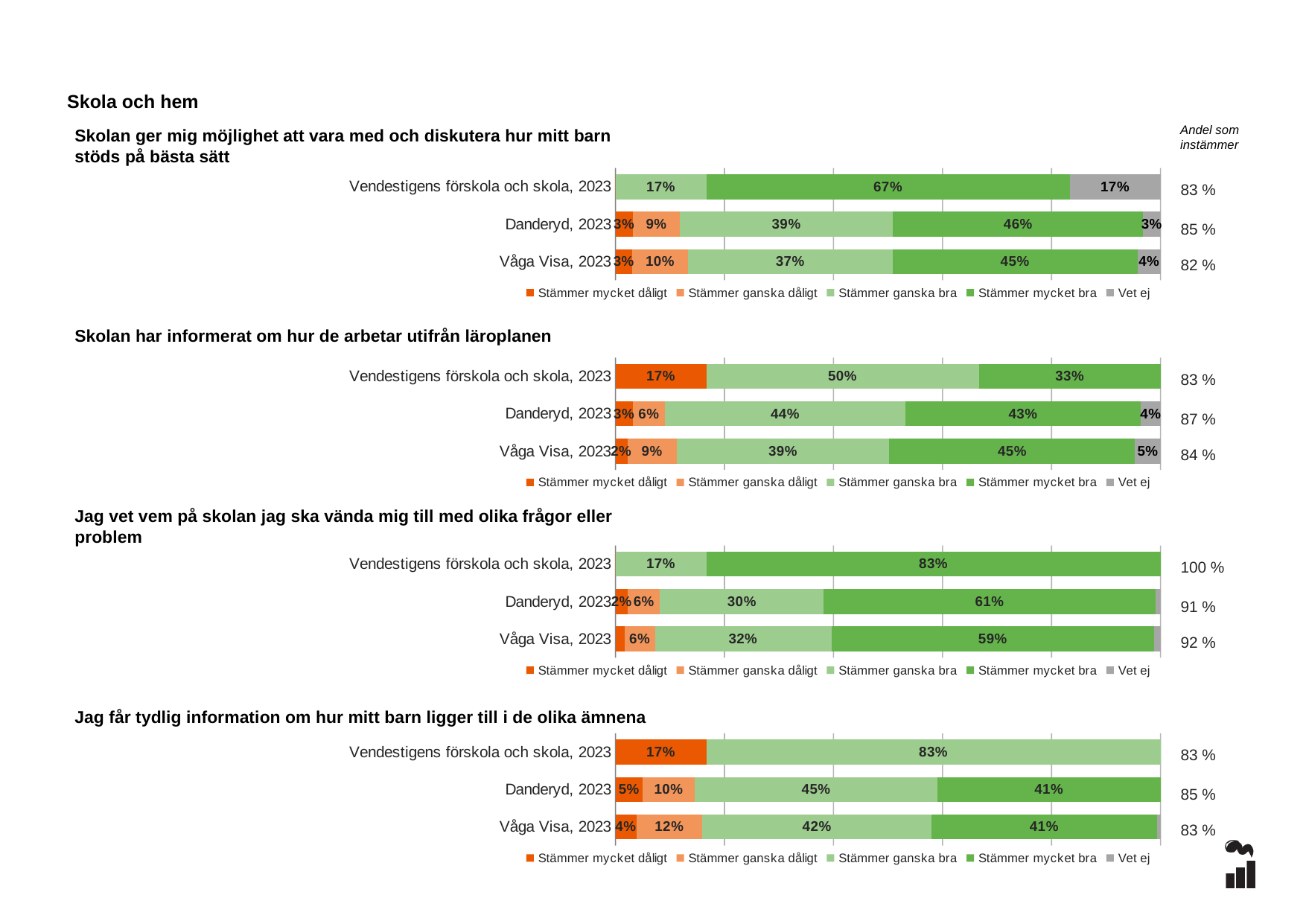
In the chart 'Jag vet vem på skolan jag ska vända mig till med olika frågor eller problem', which is larger: the 'Stämmer mycket bra' value for Danderyd, 2023 or for Våga Visa, 2023? Danderyd, 2023 How many series does the legend list for the chart 'Jag får tydlig information om hur mitt barn ligger till i de olika ämnena'? 5 In the chart 'Skolan har informerat om hur de arbetar utifrån läroplanen', what is the difference between the 'Stämmer mycket bra' values for Våga Visa, 2023 and Danderyd, 2023? 2% In the chart 'Skolan ger mig möjlighet att vara med och diskutera hur mitt barn stöds på bästa sätt', which row has the highest 'Andel som instämmer'? Danderyd, 2023 In the chart 'Skolan har informerat om hur de arbetar utifrån läroplanen', what is the 'Stämmer mycket dåligt' value for Vendestigens förskola och skola, 2023? 17% In the chart 'Skolan ger mig möjlighet att vara med och diskutera hur mitt barn stöds på bästa sätt', what is the 'Stämmer ganska bra' value for Danderyd, 2023? 39% In the chart 'Jag får tydlig information om hur mitt barn ligger till i de olika ämnena', what is the 'Stämmer ganska bra' value for Vendestigens förskola och skola, 2023? 83% In the chart 'Jag får tydlig information om hur mitt barn ligger till i de olika ämnena', what is the 'Stämmer ganska dåligt' value for Våga Visa, 2023? 12% In the chart 'Skolan har informerat om hur de arbetar utifrån läroplanen', which row has the lowest 'Andel som instämmer'? Vendestigens förskola och skola, 2023 In the chart 'Skolan ger mig möjlighet att vara med och diskutera hur mitt barn stöds på bästa sätt', what is the 'Stämmer mycket bra' value for Vendestigens förskola och skola, 2023? 67% In the chart 'Jag vet vem på skolan jag ska vända mig till med olika frågor eller problem', what is the 'Andel som instämmer' for Vendestigens förskola och skola, 2023? 100 % What kind of chart is used for 'Skolan har informerat om hur de arbetar utifrån läroplanen'? Stacked bar chart